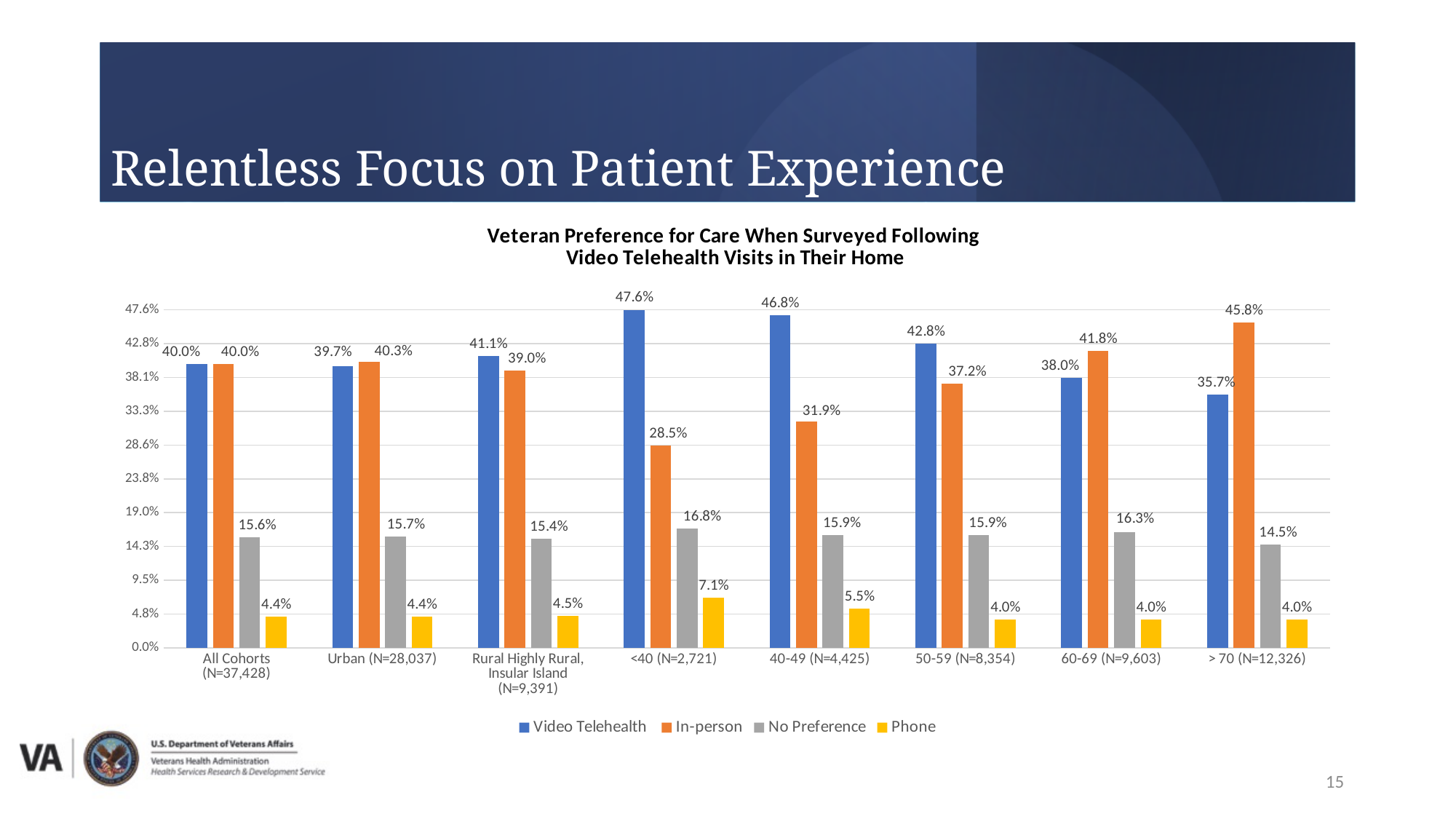
Which series is shown in orange? In-person How many categories are shown on the x axis? 8 Which category has the highest Video Telehealth value? <40 (N=2,721) What is the Video Telehealth value for the <40 (N=2,721) category? 47.6% What kind of chart is shown on the slide? Bar chart Which category has the lowest In-person value? <40 (N=2,721) What is the No Preference value for Urban (N=28,037)? 15.7% For the 60-69 (N=9,603) category, which is larger: Video Telehealth or In-person? In-person What is the difference between the Video Telehealth and In-person values for the 50-59 (N=8,354) category? 5.6% How many series does the legend list? 4 What is the Phone value for the 40-49 (N=4,425) category? 5.5% What is the In-person value for the > 70 (N=12,326) category? 45.8%